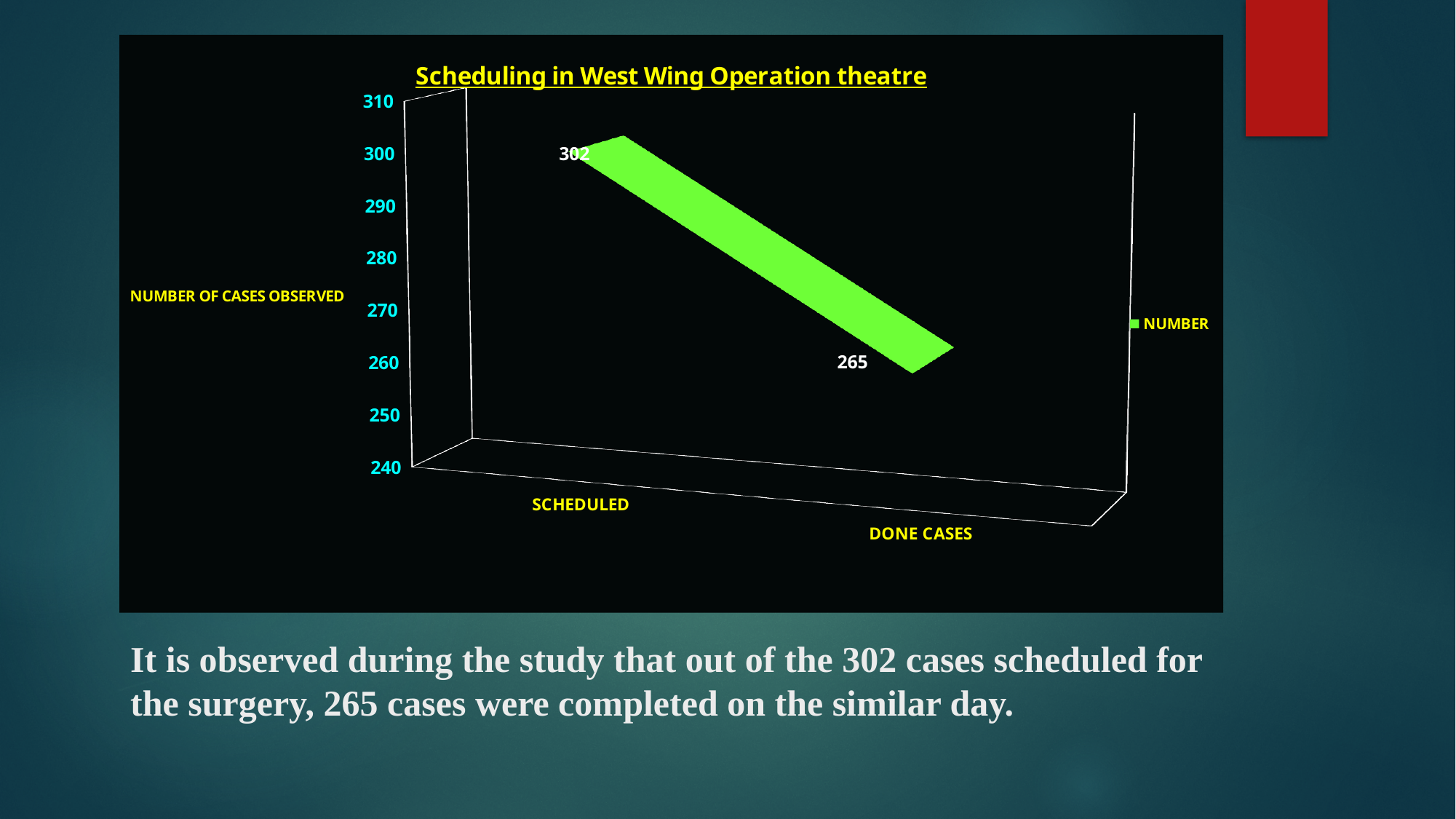
Do the values rise or fall from SCHEDULED to DONE CASES? fall Is the value for SCHEDULED greater or less than 290? greater Which category has the lowest value? DONE CASES Which is larger, the value for SCHEDULED or the value for DONE CASES? SCHEDULED What is the title of the chart? Scheduling in West Wing Operation theatre Is the value for DONE CASES greater or less than 270? less What is the difference between the SCHEDULED and DONE CASES values? 37 What is the value for DONE CASES? 265 Which category has the highest value? SCHEDULED How many categories are shown on the x axis? 2 What is the value for SCHEDULED? 302 How many series does the legend list? 1